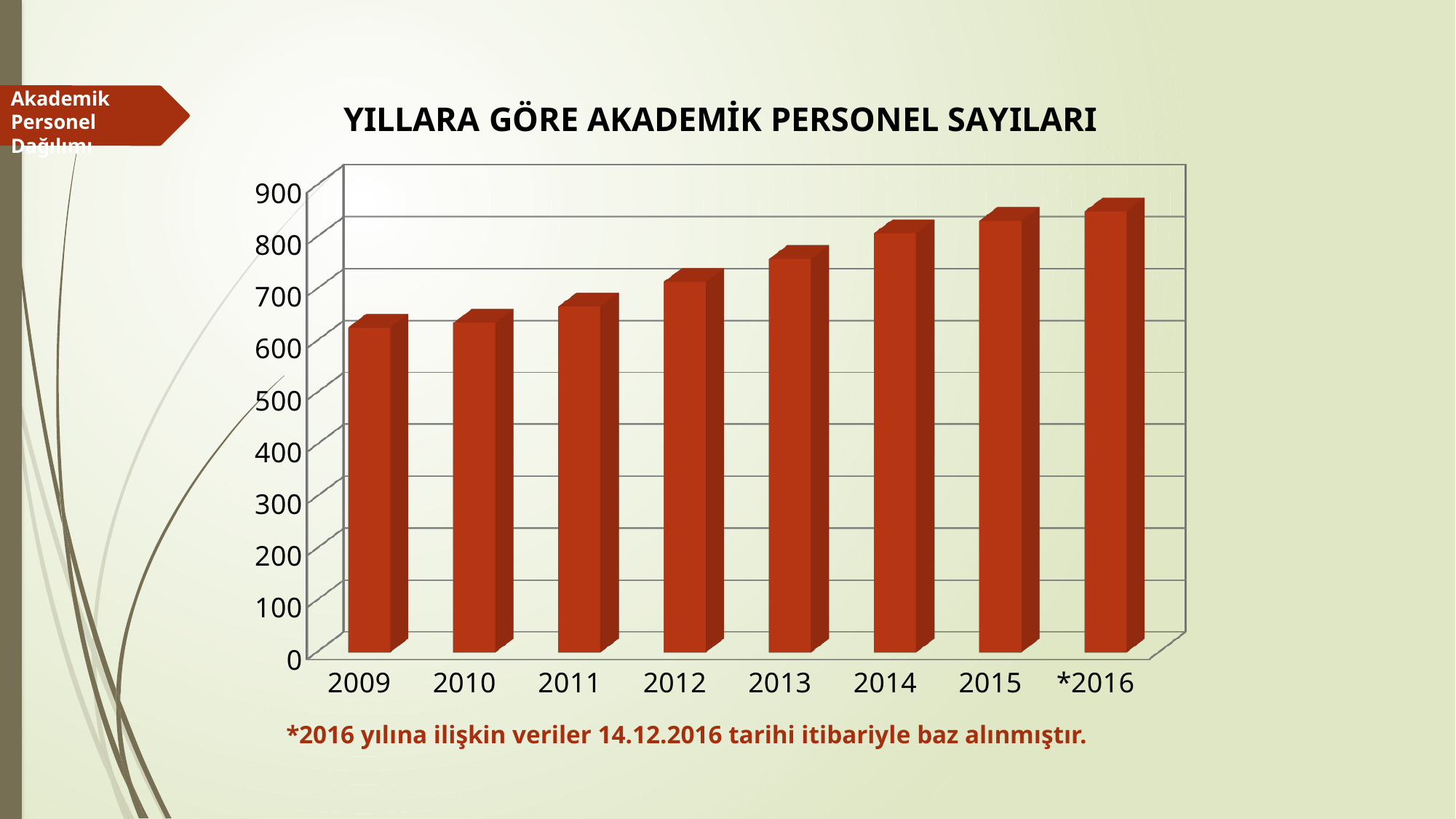
What kind of chart is shown on the slide? bar chart According to the footnote, as of which date were the 2016 data taken? 14.12.2016 Is the value for 2012 greater or less than 800? less Is the value for 2009 greater or less than 700? less Is the value for *2016 greater or less than 800? greater Do the values rise or fall from 2009 to *2016? rise What is the title of the chart? YILLARA GÖRE AKADEMİK PERSONEL SAYILARI How many years are shown on the x axis of the chart? 8 Which year has the lowest number of academic staff? 2009 Which year has the highest number of academic staff? *2016 Which is larger, the value for 2015 or the value for 2010? 2015